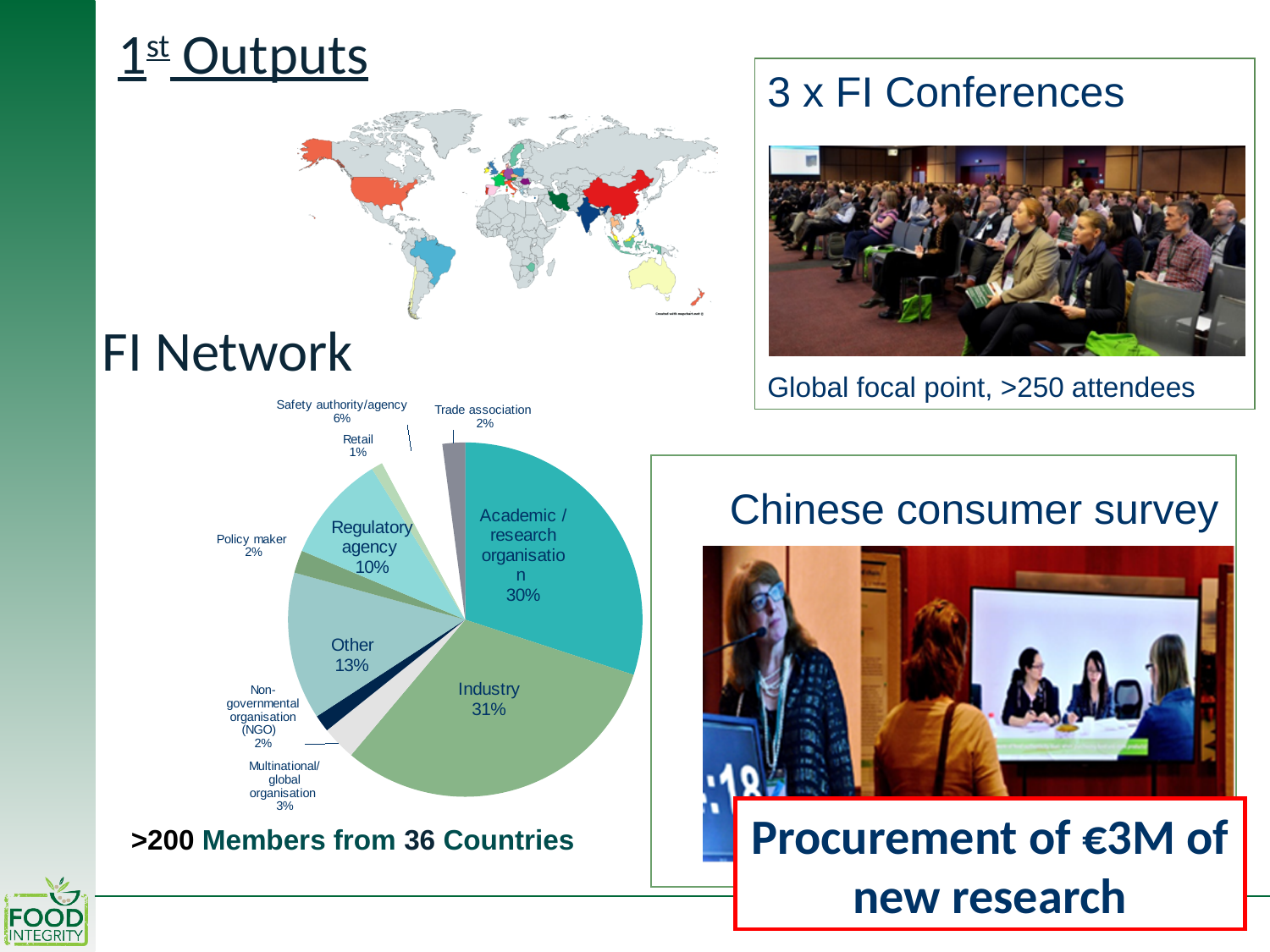
What share of the FI Network pie chart is Academic / research organisation? 30% What share of the FI Network pie chart is Regulatory agency? 10% Which category has the largest share in the FI Network pie chart? Industry What share of the FI Network pie chart is Multinational/global organisation? 3% What caption appears below the FI Network pie chart? >200 Members from 36 Countries In the FI Network pie chart, what is the difference between the Other share and the Regulatory agency share? 3% Which category has the smallest share in the FI Network pie chart? Retail In the FI Network pie chart, which is larger: Other or Safety authority/agency? Other How many categories are shown in the FI Network pie chart? 10 What kind of chart is shown under the 'FI Network' heading? pie chart What share of the FI Network pie chart is Safety authority/agency? 6% What share of the FI Network pie chart is Industry? 31%